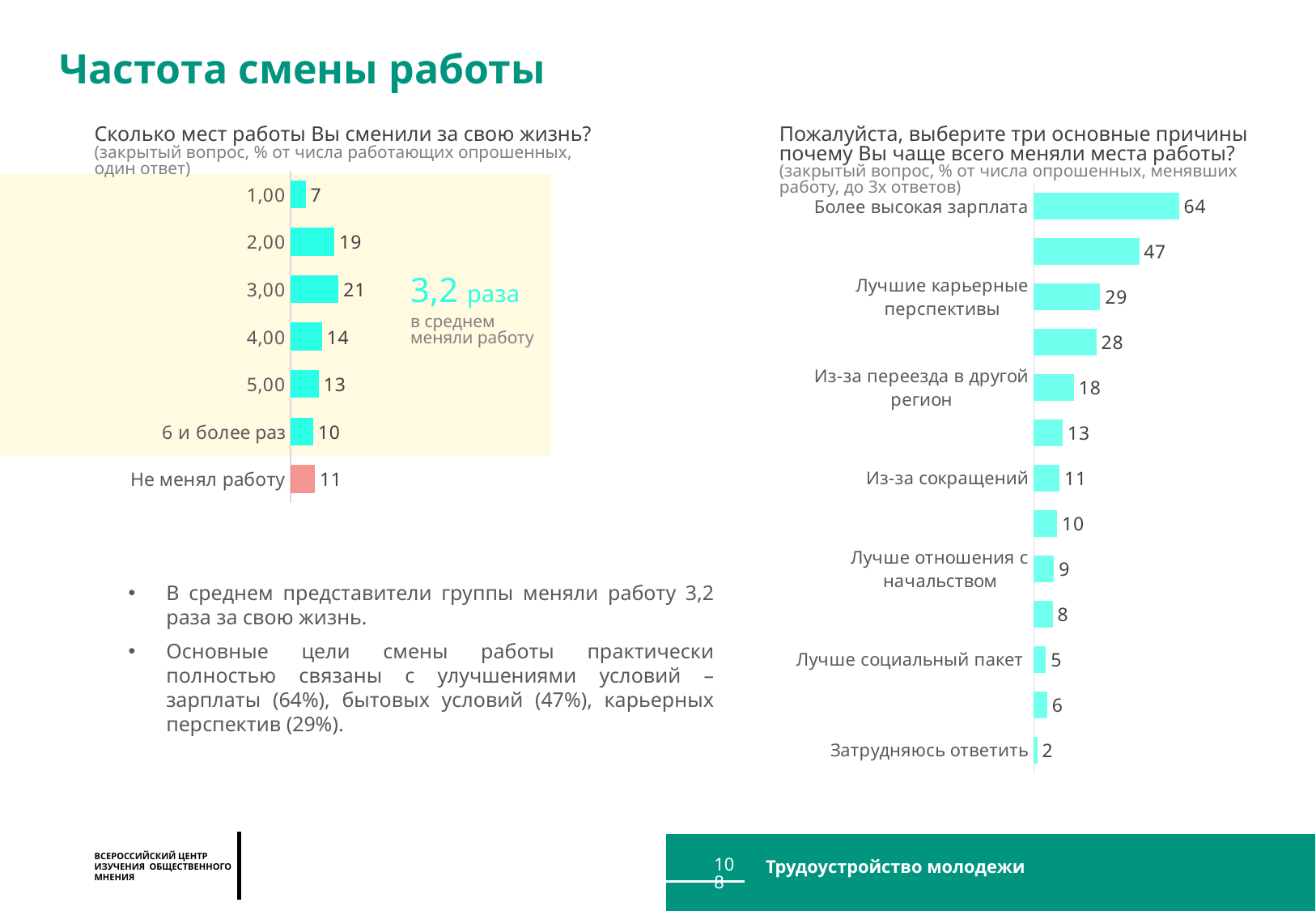
In the left chart (Сколько мест работы Вы сменили за свою жизнь?), what is the value for Не менял работу? 11 In the right chart (причины смены места работы), how many bars are shown? 13 In the right chart (причины смены места работы), which is larger: Лучшие карьерные перспективы or Из-за сокращений? Лучшие карьерные перспективы In the right chart (причины смены места работы), what is the value for Из-за переезда в другой регион? 18 In the left chart (Сколько мест работы Вы сменили за свою жизнь?), which category has the lowest value? 1,00 In the left chart (Сколько мест работы Вы сменили за свою жизнь?), how many categories are shown? 7 In the right chart (причины смены места работы), what is the value for Более высокая зарплата? 64 In the right chart (причины смены места работы), what is the difference between Более высокая зарплата and Лучшие карьерные перспективы? 35 In the left chart (Сколько мест работы Вы сменили за свою жизнь?), what is the difference between the values for 2,00 and 1,00? 12 In the left chart (Сколько мест работы Вы сменили за свою жизнь?), what is the value for 3,00? 21 What type of chart is the right chart (причины смены места работы)? Bar chart In the left chart (Сколько мест работы Вы сменили за свою жизнь?), which category has the highest value? 3,00